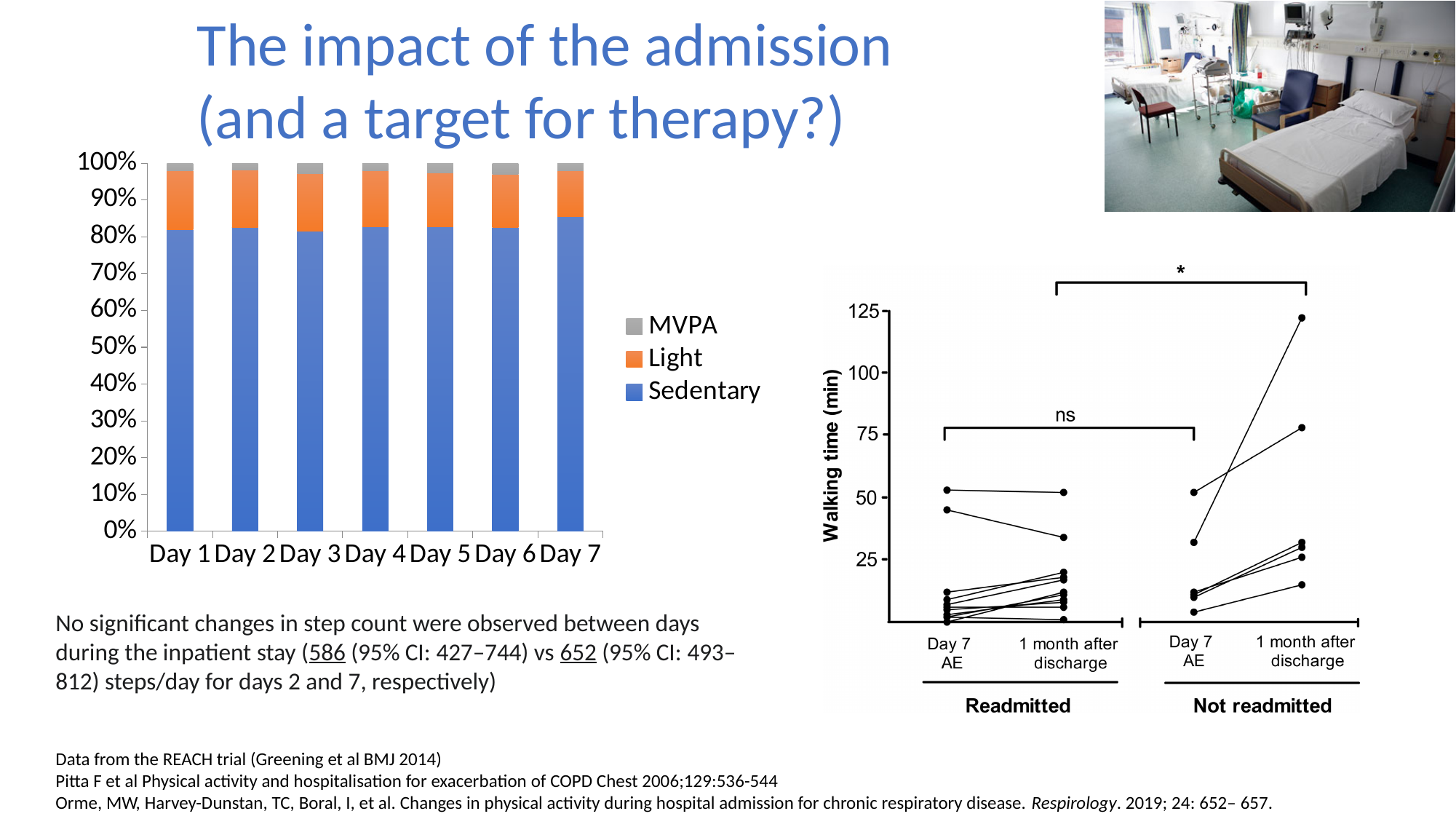
In the left-hand stacked bar chart, which series is shown in blue? Sedentary In the left-hand stacked bar chart, what does each stacked bar total? 100% In the left-hand stacked bar chart, how many series does the legend list? 3 In the left-hand stacked bar chart, is the Sedentary value for Day 1 greater or less than 90%? less In the left-hand stacked bar chart, is the Sedentary value for Day 7 greater or less than 80%? greater In the left-hand stacked bar chart, how many days are shown on the x axis? 7 In the left-hand stacked bar chart, which series occupies the largest share of each bar? Sedentary In the right-hand walking time chart, what is the label on the y axis? Walking time (min) In the right-hand walking time chart, is the highest value at 1 month after discharge in the Not readmitted group greater or less than 100? greater In the right-hand walking time chart, which group, Readmitted or Not readmitted, has the higher maximum walking time at 1 month after discharge? Not readmitted In the left-hand stacked bar chart, which series occupies the smallest share of each bar? MVPA What type of chart is the left-hand chart showing Day 1 to Day 7? Stacked bar chart